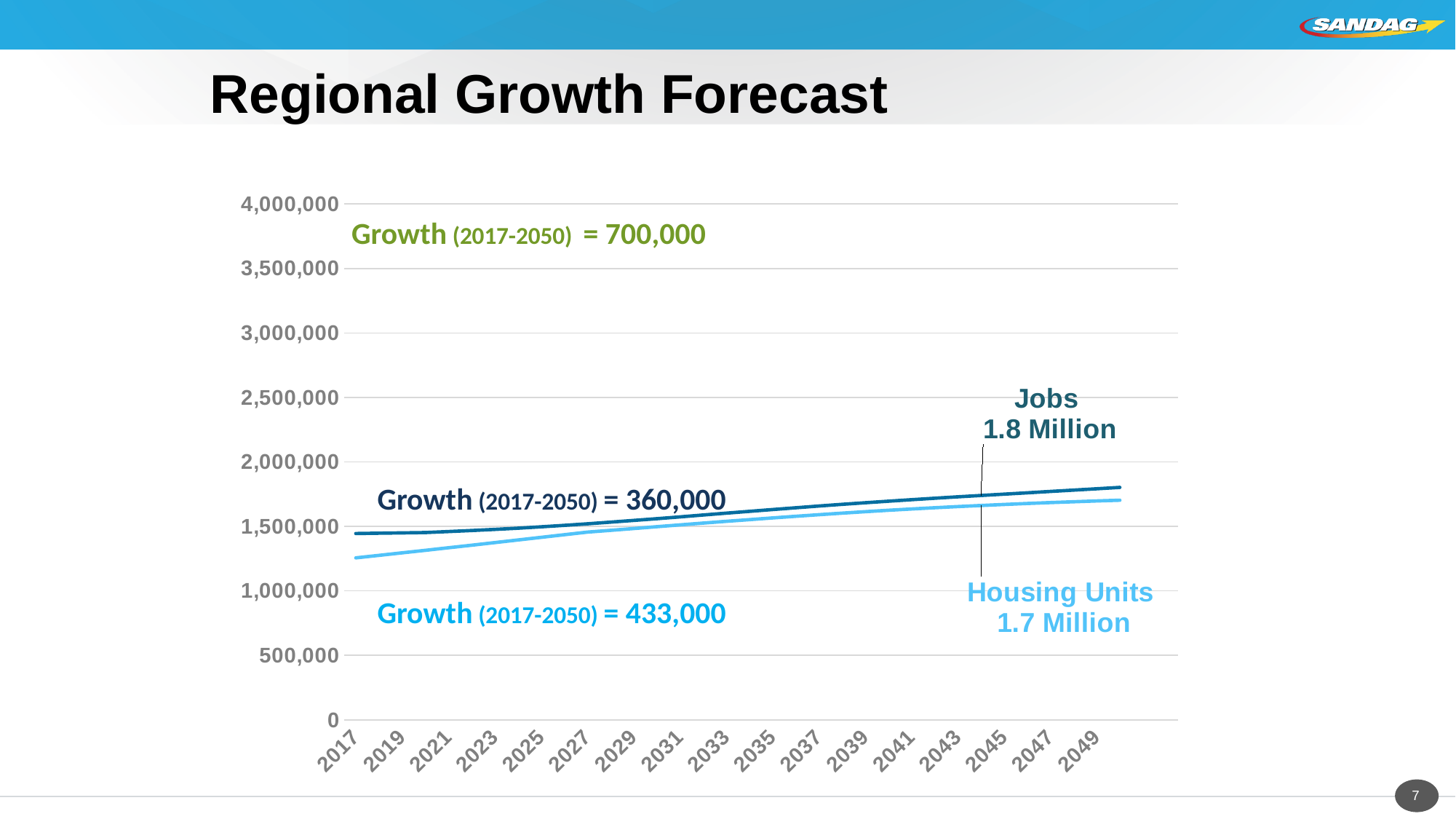
What is the difference between the Housing Units growth and the Jobs growth for 2017-2050? 73,000 What is the forecast growth in Housing Units from 2017 to 2050? 433,000 Do the Jobs and Housing Units lines rise or fall from 2017 to 2049? rise What is the highest value shown on the vertical axis? 4,000,000 What is the forecast growth in Jobs from 2017 to 2050? 360,000 What kind of chart is shown on the slide? line chart Which line is higher across the chart, Jobs or Housing Units? Jobs What value is labelled for Housing Units at the end of the forecast? 1.7 Million What value is labelled for Jobs at the end of the forecast? 1.8 Million Is the value for Housing Units in 2017 greater or less than 1,500,000? less Is the value for Jobs in 2049 greater or less than 1,500,000? greater Which has the larger forecast growth from 2017 to 2050, Jobs or Housing Units? Housing Units